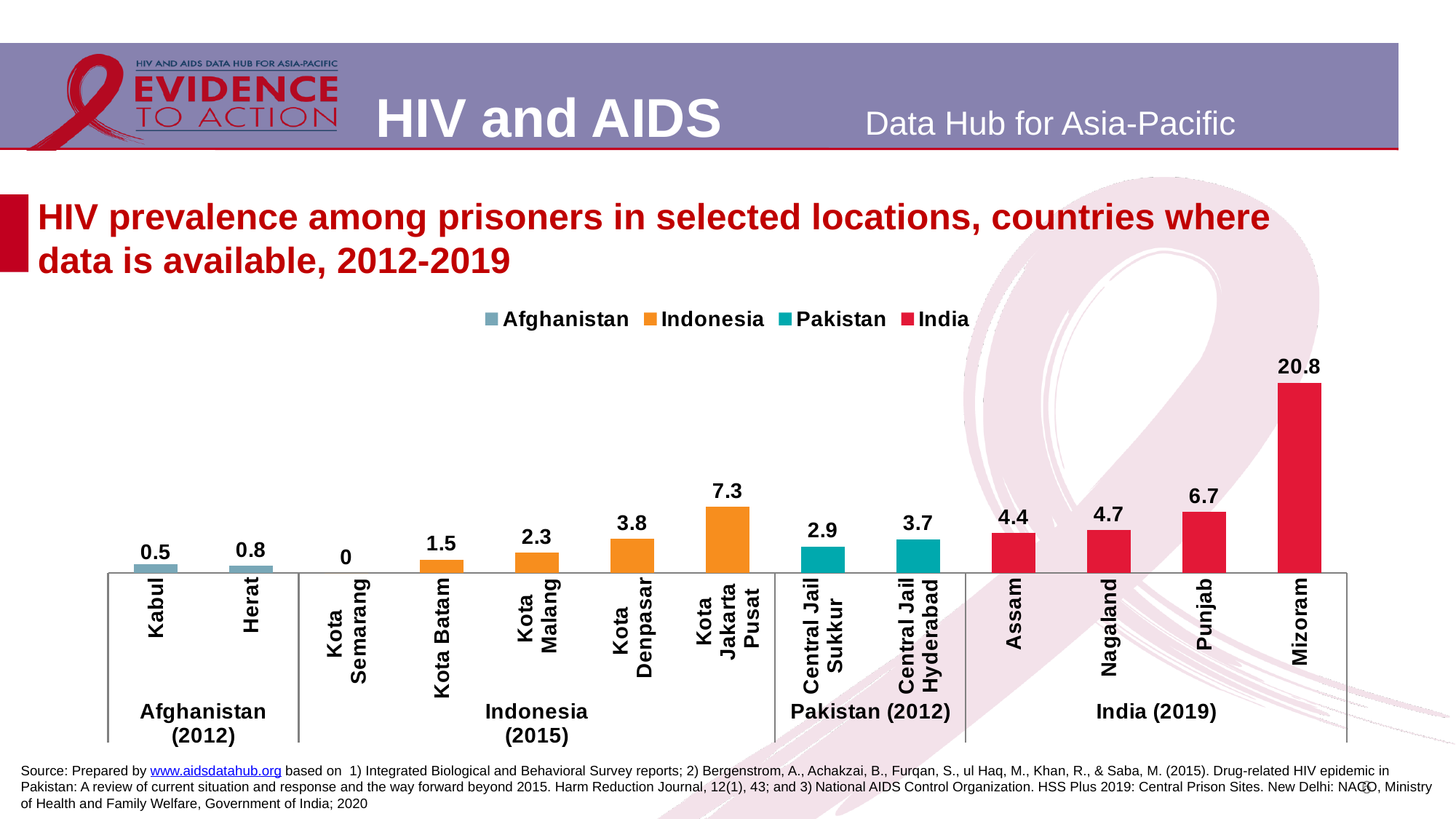
What is the difference between the values for Kota Denpasar and Kota Batam? 2.3 Which location has the highest HIV prevalence among prisoners? Mizoram What kind of chart is shown on the slide? Bar chart Which has a higher value, Central Jail Sukkur or Nagaland? Nagaland What is the value shown for Kabul? 0.5 What is the difference between the values for Mizoram and Punjab? 14.1 How many locations are plotted on the chart? 13 How many series does the legend list? 4 What is the value shown for Kota Jakarta Pusat? 7.3 What is the HIV prevalence among prisoners in Mizoram? 20.8 What is the value shown for Central Jail Hyderabad? 3.7 Which location has the lowest value on the chart? Kota Semarang